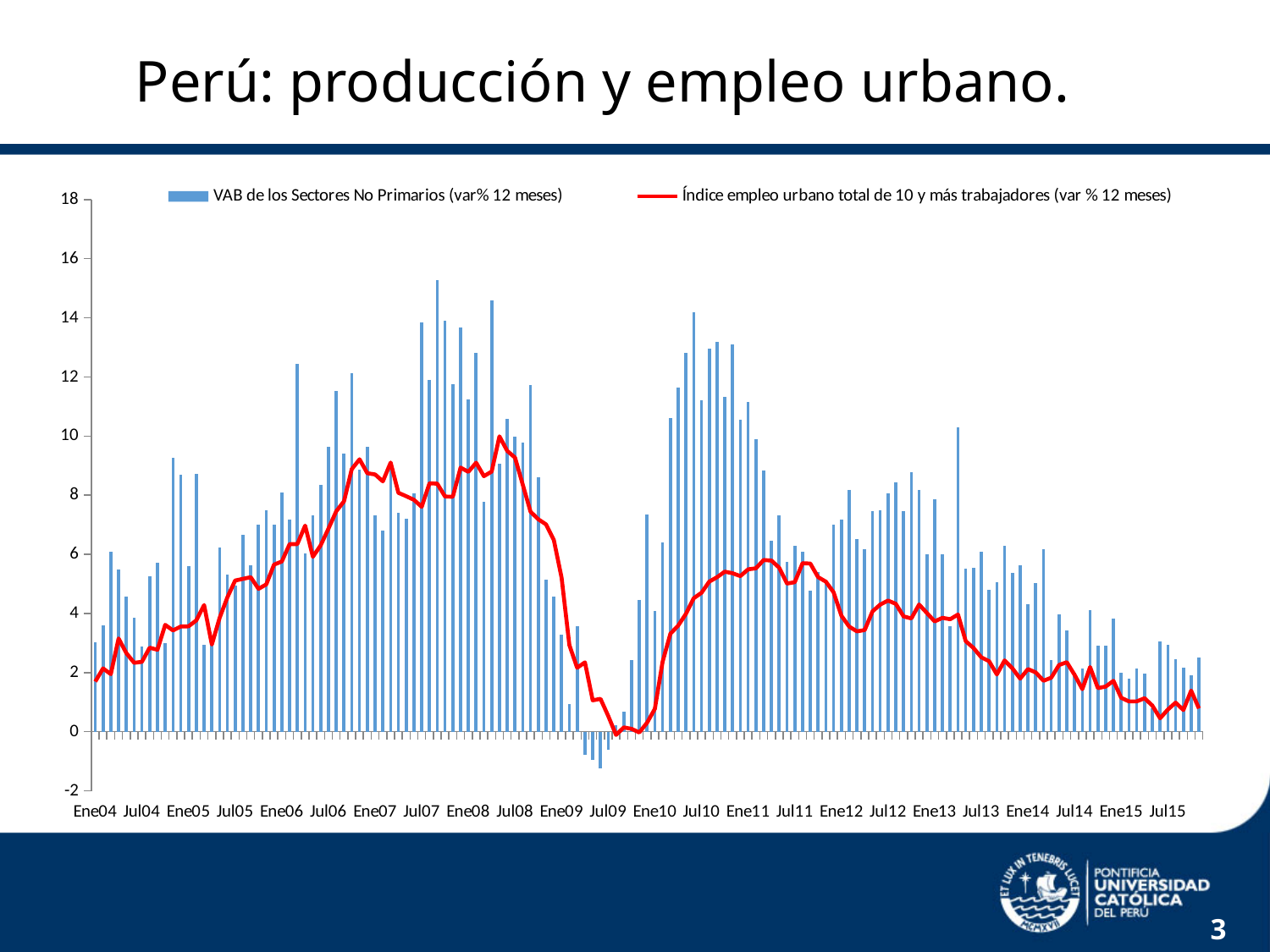
Is the Índice empleo urbano line value at Jul08 greater or less than 8? greater Is the Índice empleo urbano line value at Jul15 greater or less than 2? less Which series is drawn as a red line in the chart? Índice empleo urbano total de 10 y más trabajadores (var % 12 meses) Does the Índice empleo urbano line rise or fall between Jul09 and Jul10? rise Is the Índice empleo urbano line value at Jul10 greater or less than 4? greater How many series does the chart's legend list? 2 What is the title of the slide containing the chart? Perú: producción y empleo urbano. Does the Índice empleo urbano line rise or fall between Ene09 and Jul09? fall Which is larger, the Índice empleo urbano line value at Jul08 or at Jul15? Jul08 How many labels are shown along the x axis of the chart? 24 What kind of chart is shown on the slide? A combined bar and line chart